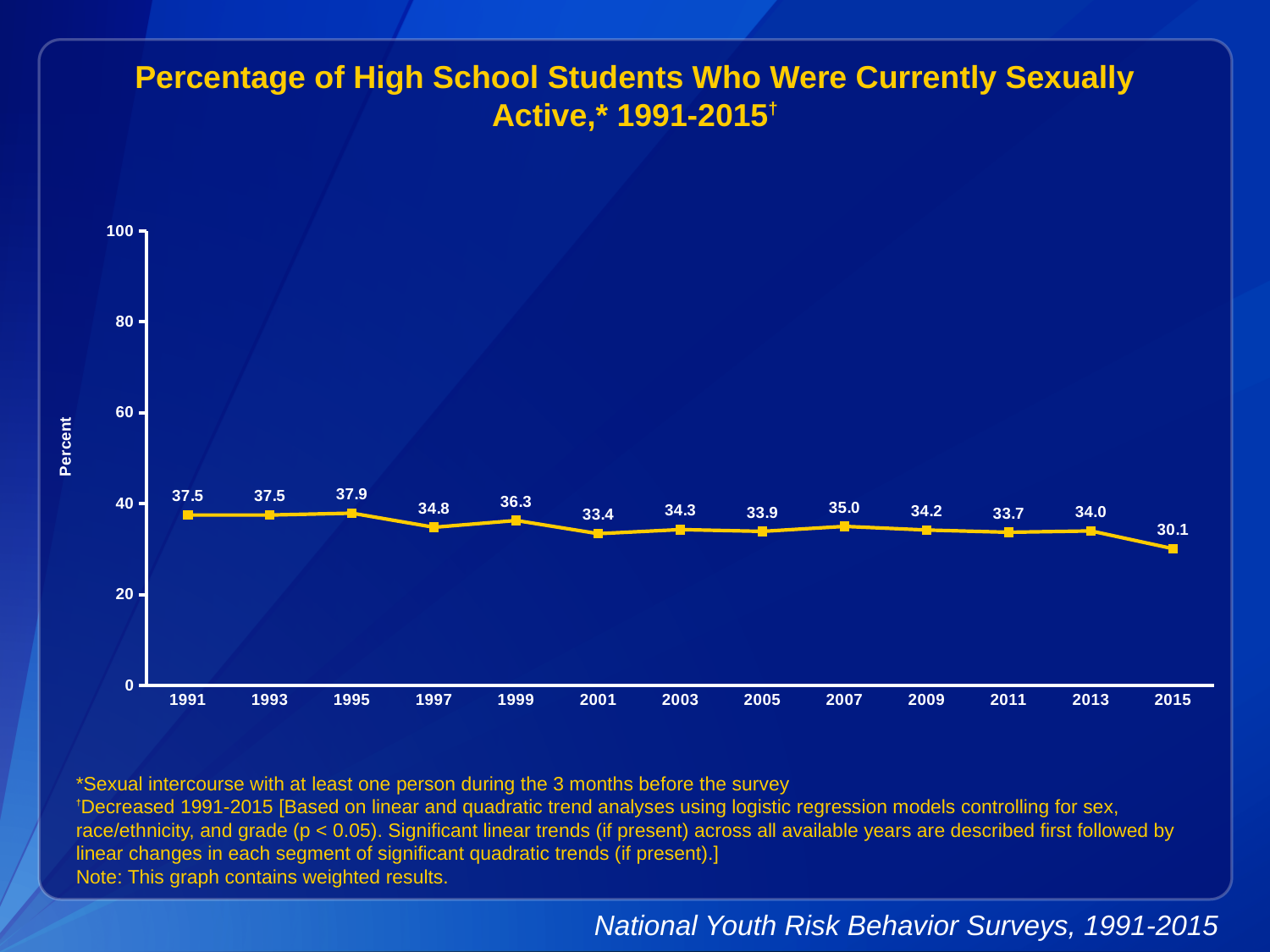
Overall, do the values rise or fall from 1991 to 2015? fall What was the percentage of high school students who were currently sexually active in 1991? 37.5 What was the percentage of high school students who were currently sexually active in 2015? 30.1 What kind of chart is shown on the slide? line chart What is the label on the y axis? Percent What value is plotted for 2007? 35.0 Which year has the lowest percentage? 2015 Which is larger, the value for 1999 or the value for 2001? 1999 What is the difference between the 1991 value and the 2015 value? 7.4 Which year has the highest percentage? 1995 How many years are plotted on the chart? 13 Is the value for 2015 greater or less than 40? less